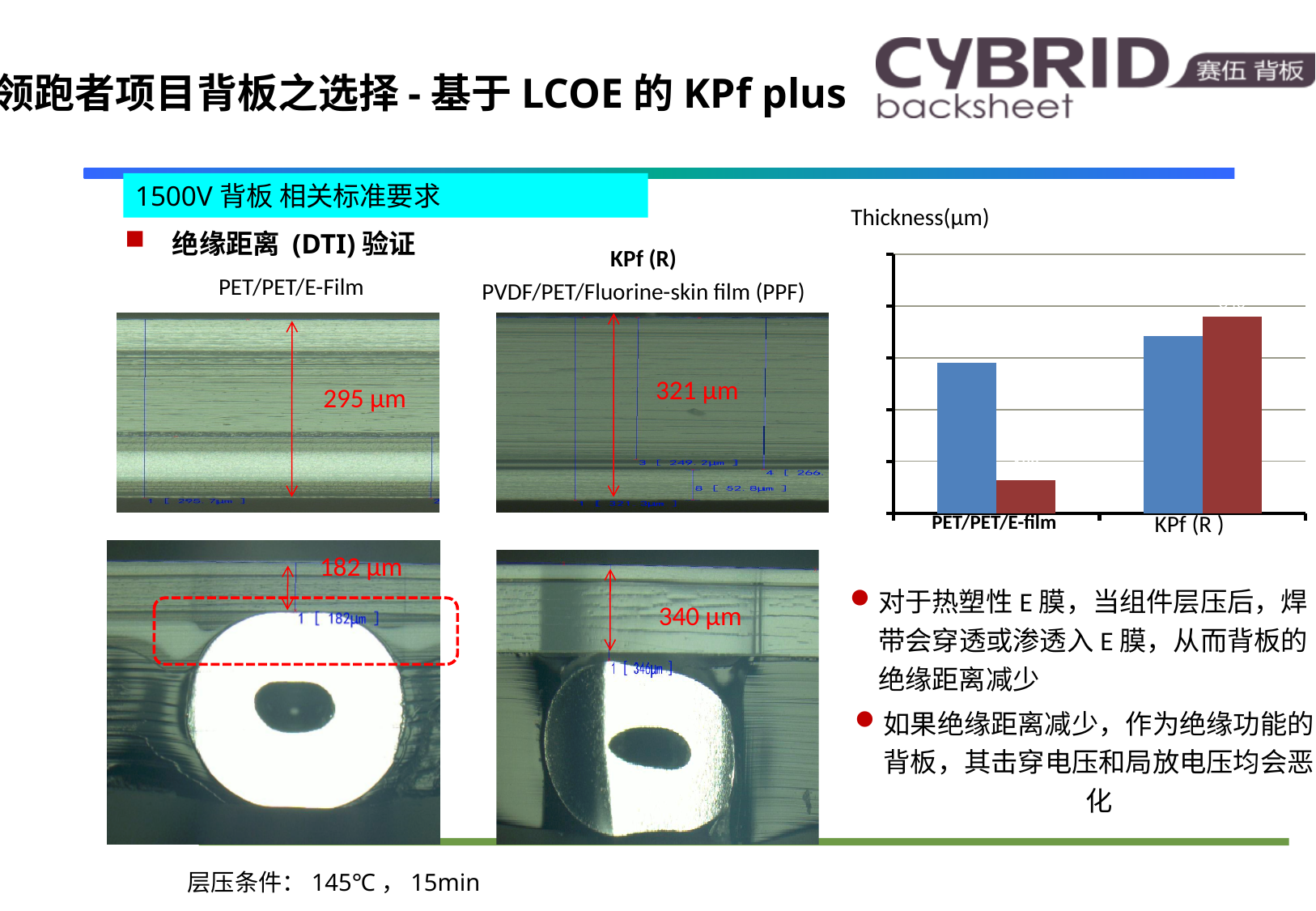
In the Thickness(μm) chart, for the PET/PET/E-film category, is the blue bar or the red bar taller? blue bar In the Thickness(μm) chart, which category has the tallest bar overall? KPf (R) In the Thickness(μm) chart, which category has the taller red bar, PET/PET/E-film or KPf (R)? KPf (R) In the Thickness(μm) chart, what is the label of the first category on the x axis? PET/PET/E-film What are the two bar colours used in the Thickness(μm) chart? blue and red How many bars are plotted in the Thickness(μm) chart? 4 What kind of chart is shown on the right side of the slide? bar chart How many categories are shown on the x axis of the Thickness(μm) chart? 2 In the Thickness(μm) chart, which category has the shortest bar overall? PET/PET/E-film What is the title of the bar chart on the right side of the slide? Thickness(μm) In the Thickness(μm) chart, which category has the taller blue bar, PET/PET/E-film or KPf (R)? KPf (R)